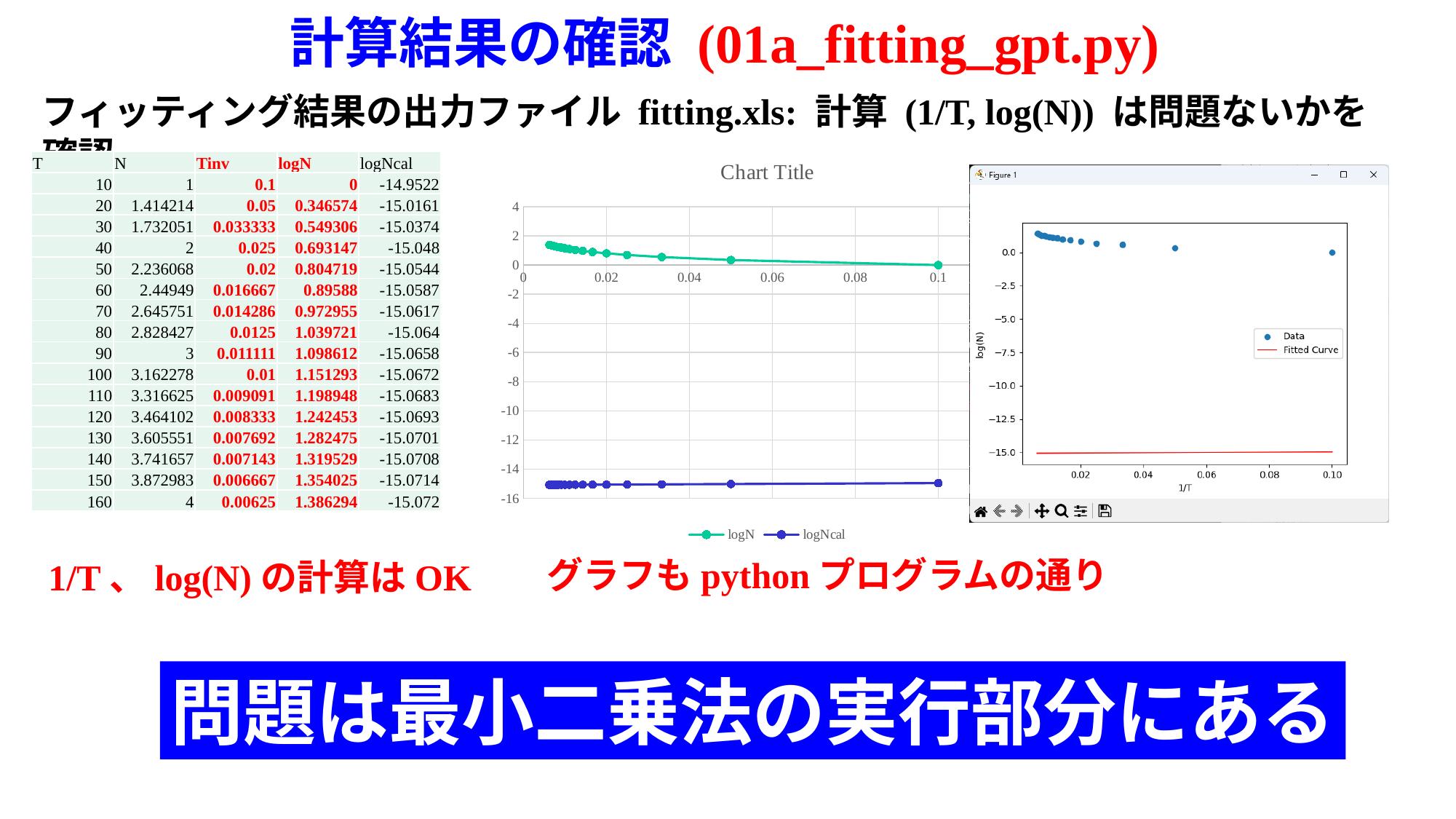
What kind of chart is the middle chart? line chart with markers In the right-hand chart (Figure 1), is the Fitted Curve greater or less than -10? less How many entries does the legend of the right-hand chart (Figure 1) list? 2 In the middle chart, does the logN series rise or fall as 1/T increases? fall In the middle chart, what is the logN value at 1/T = 0.1? 0 In the middle chart, which series has the higher values, logN or logNcal? logN In the middle chart, is the value of logNcal at 1/T = 0.1 greater or less than -14? less In the middle chart, is the value of logN at 1/T = 0.02 greater or less than 2? less How many series does the legend of the middle chart list? 2 What is the x-axis label of the right-hand chart (Figure 1)? 1/T What is the title of the middle chart? Chart Title What are the two series named in the legend of the middle chart? logN and logNcal